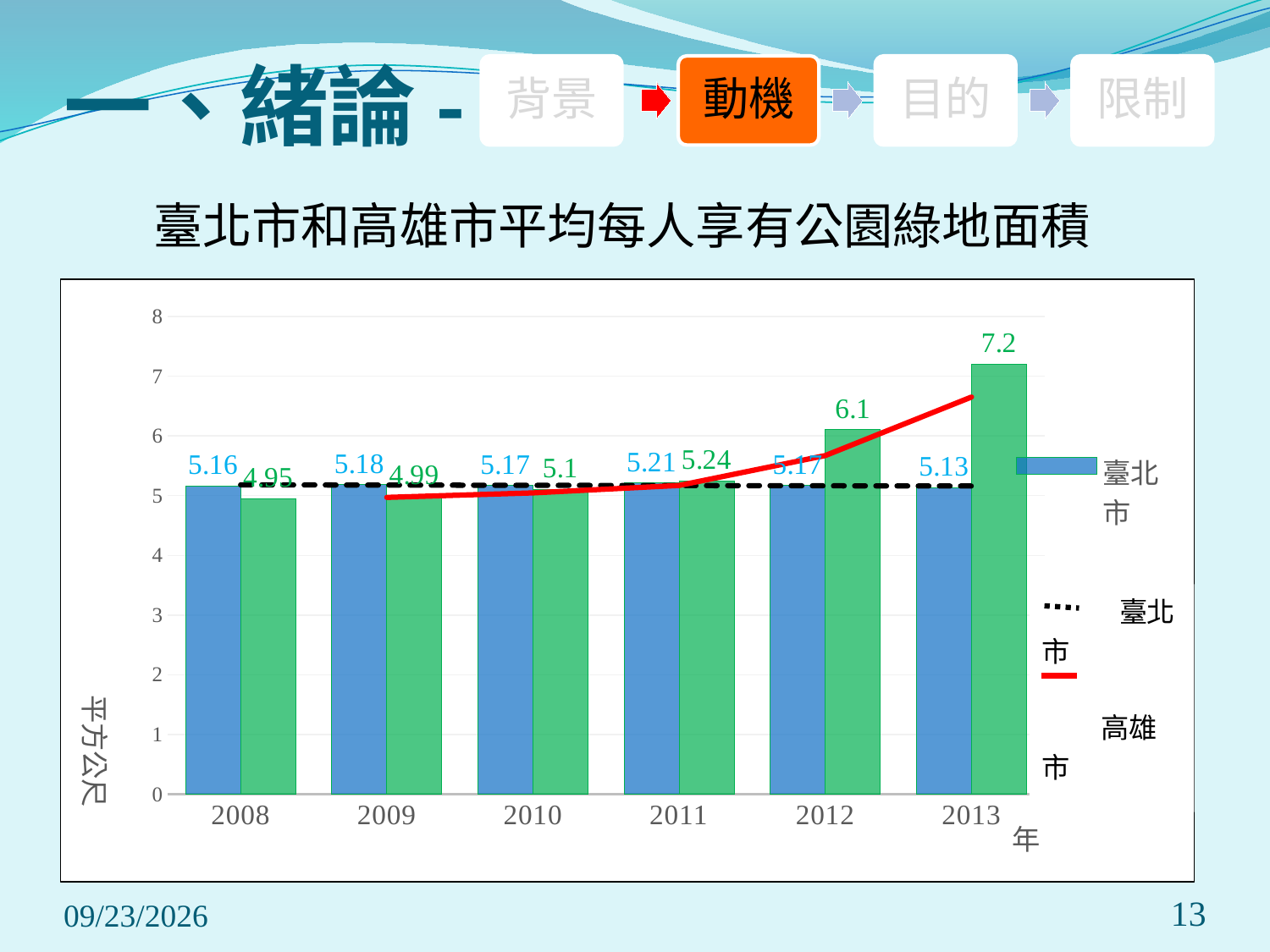
Is the value for 高雄市 in 2012 greater or less than 6? greater How many years are shown on the x axis? 6 What kind of chart is this? bar chart Do the values for 高雄市 rise or fall from 2008 to 2013? rise What is the value for 高雄市 in 2013? 7.2 What is the value for 臺北市 in 2008? 5.16 In 2012, which is larger, the value for 臺北市 or for 高雄市? 高雄市 In which year is the value for 高雄市 highest? 2013 What is the value for 臺北市 in 2011? 5.21 What is the value for 高雄市 in 2010? 5.1 What is the difference between the 高雄市 and 臺北市 values in 2013? 2.07 In which year is the value for 高雄市 lowest? 2008